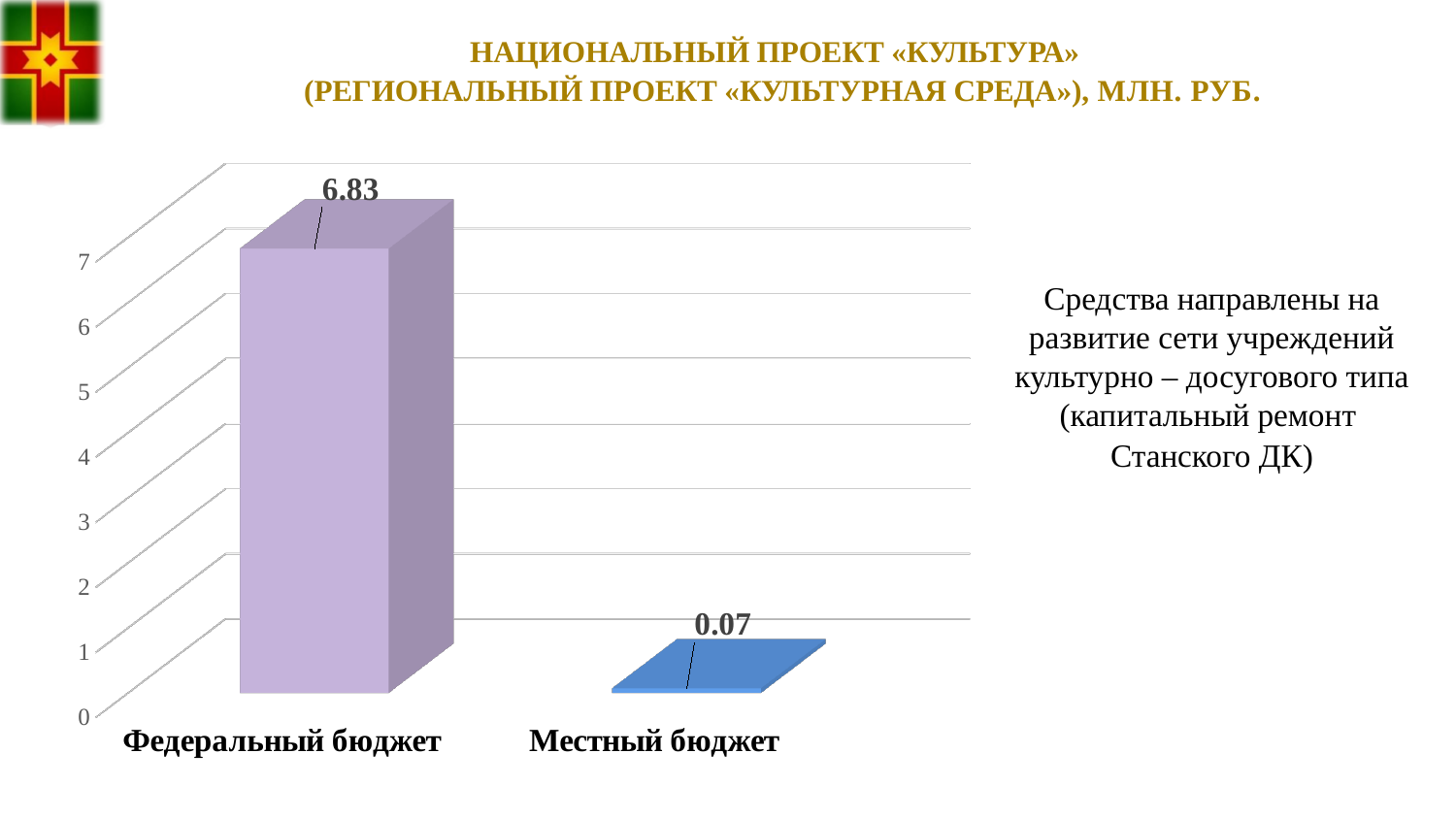
What is the value for Федеральный бюджет? 6.83 Is the value for Федеральный бюджет greater or less than 5? greater Which category has the lowest value? Местный бюджет What is the difference between the values for Федеральный бюджет and Местный бюджет? 6.76 Which category has the highest value? Федеральный бюджет Which is larger, the value for Федеральный бюджет or the value for Местный бюджет? Федеральный бюджет Is the value for Местный бюджет greater or less than 1? less What unit is stated in the chart title? млн. руб. What kind of chart is shown on the slide? bar chart What is the value for Местный бюджет? 0.07 What is the total of the two values shown in the chart? 6.90 How many categories are shown in the chart? 2